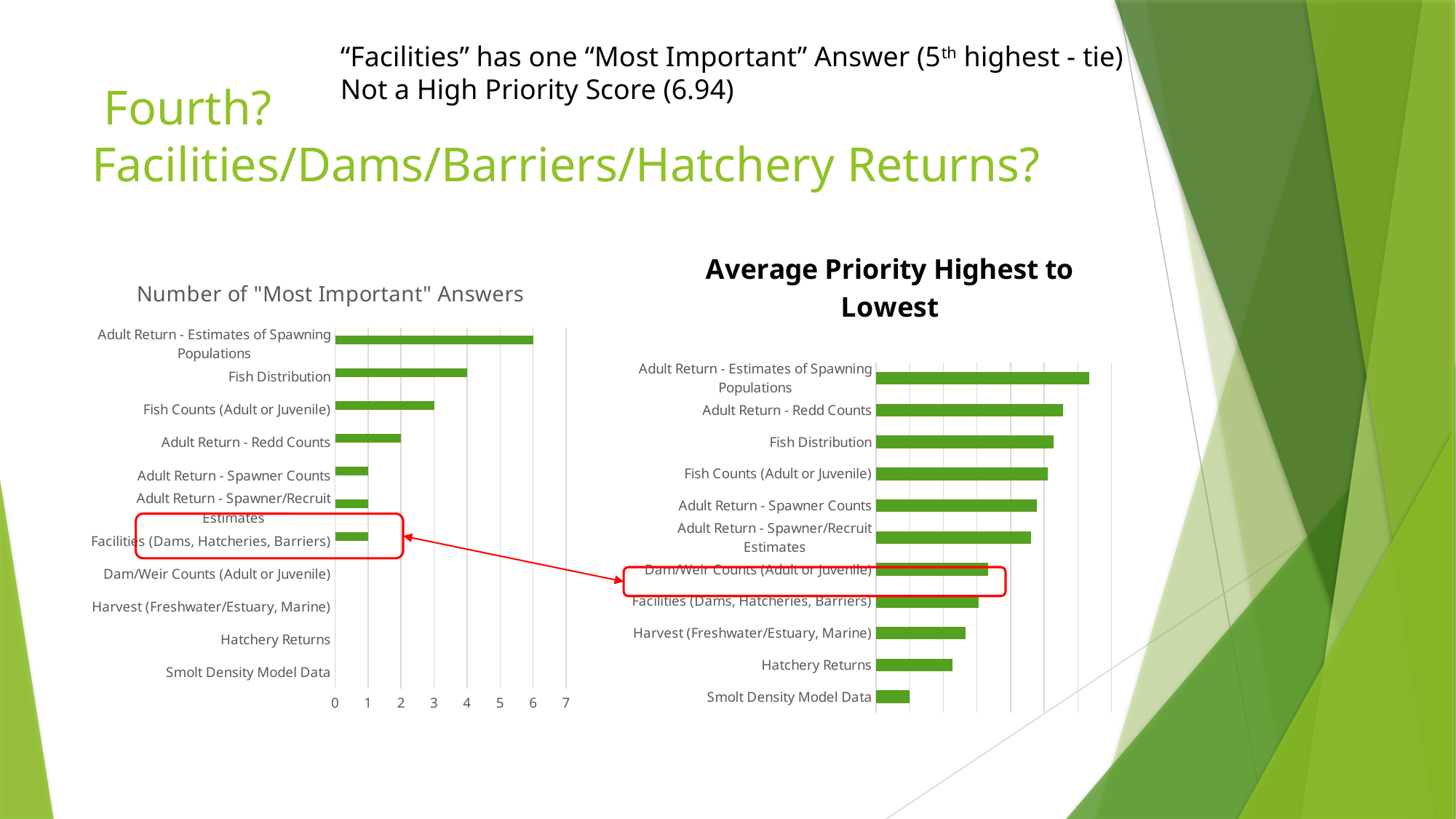
In the "Number of "Most Important" Answers" chart, what is the value for Fish Counts (Adult or Juvenile)? 3 In the "Number of "Most Important" Answers" chart, which is larger, Fish Counts (Adult or Juvenile) or Adult Return - Redd Counts? Fish Counts (Adult or Juvenile) In the "Number of "Most Important" Answers" chart, what is the difference between Fish Distribution and Adult Return - Redd Counts? 2 In the "Average Priority Highest to Lowest" chart, which category has the lowest value? Smolt Density Model Data In the "Number of "Most Important" Answers" chart, what is the value for Adult Return - Estimates of Spawning Populations? 6 How many categories are shown in the "Number of "Most Important" Answers" chart? 11 In the "Average Priority Highest to Lowest" chart, which is larger, Harvest (Freshwater/Estuary, Marine) or Hatchery Returns? Harvest (Freshwater/Estuary, Marine) What type of chart is the "Average Priority Highest to Lowest" chart? Bar chart In the "Average Priority Highest to Lowest" chart, which category has the highest value? Adult Return - Estimates of Spawning Populations In the "Number of "Most Important" Answers" chart, what is the value for Facilities (Dams, Hatcheries, Barriers)? 1 In the "Number of "Most Important" Answers" chart, which category has the highest value? Adult Return - Estimates of Spawning Populations In the "Number of "Most Important" Answers" chart, what is the value for Fish Distribution? 4